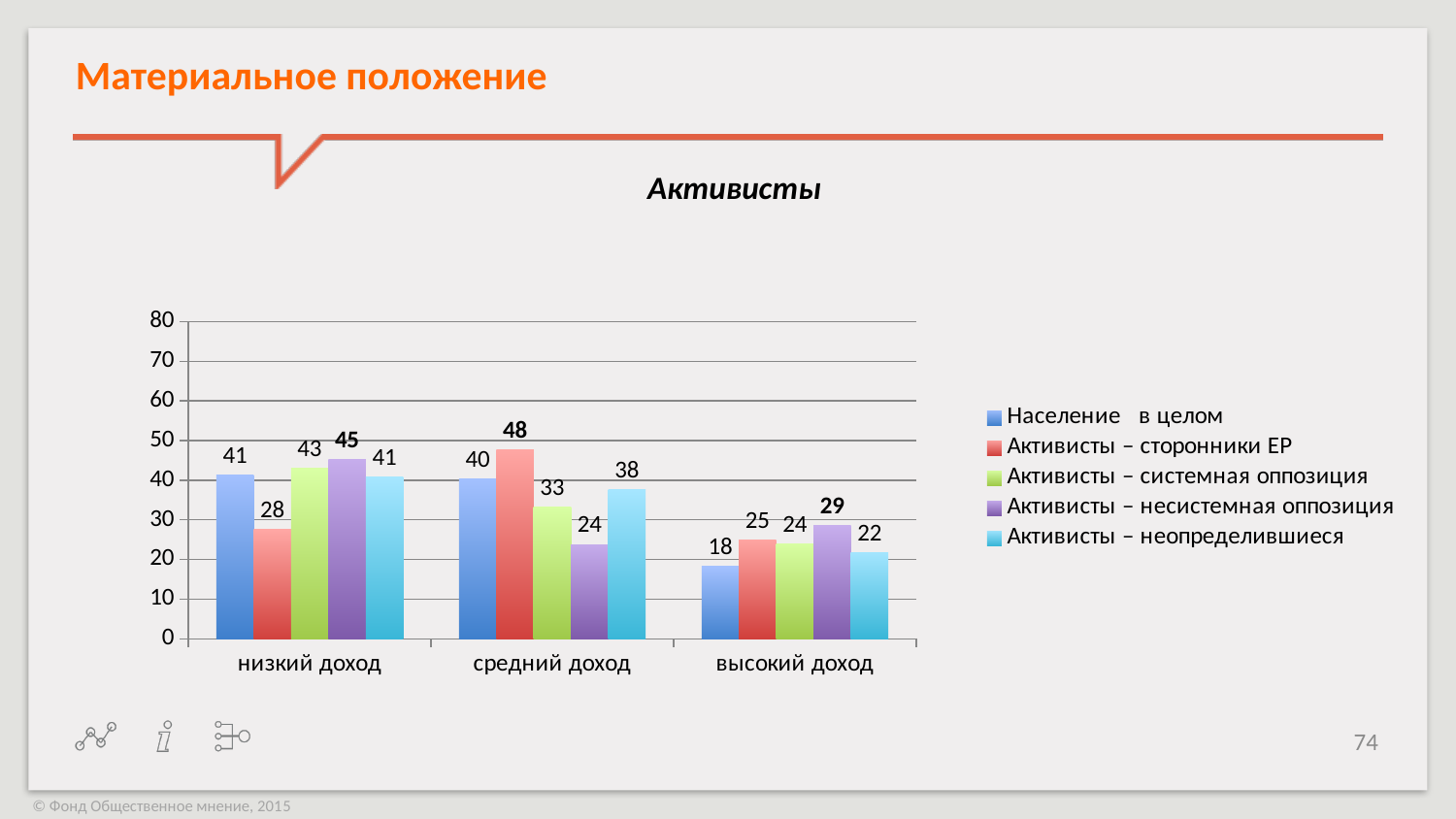
Is the value for «Активисты – сторонники ЕР» in the «низкий доход» category greater or less than 30? less What kind of chart is shown on the slide? bar chart Which series has the lowest value in the «средний доход» category? Активисты – несистемная оппозиция Which series has the highest value in the «низкий доход» category? Активисты – несистемная оппозиция What is the value for «Активисты – несистемная оппозиция» in the «низкий доход» category? 45 What is the value for «Активисты – сторонники ЕР» in the «средний доход» category? 48 Do the values for «Население в целом» rise or fall from «низкий доход» to «высокий доход»? fall In the «высокий доход» category, which is larger: «Активисты – несистемная оппозиция» or «Активисты – неопределившиеся»? Активисты – несистемная оппозиция What is the value for «Население в целом» in the «высокий доход» category? 18 What is the difference between «Активисты – сторонники ЕР» and «Население в целом» in the «средний доход» category? 8 How many series does the legend list? 5 How many income categories are shown on the x axis? 3